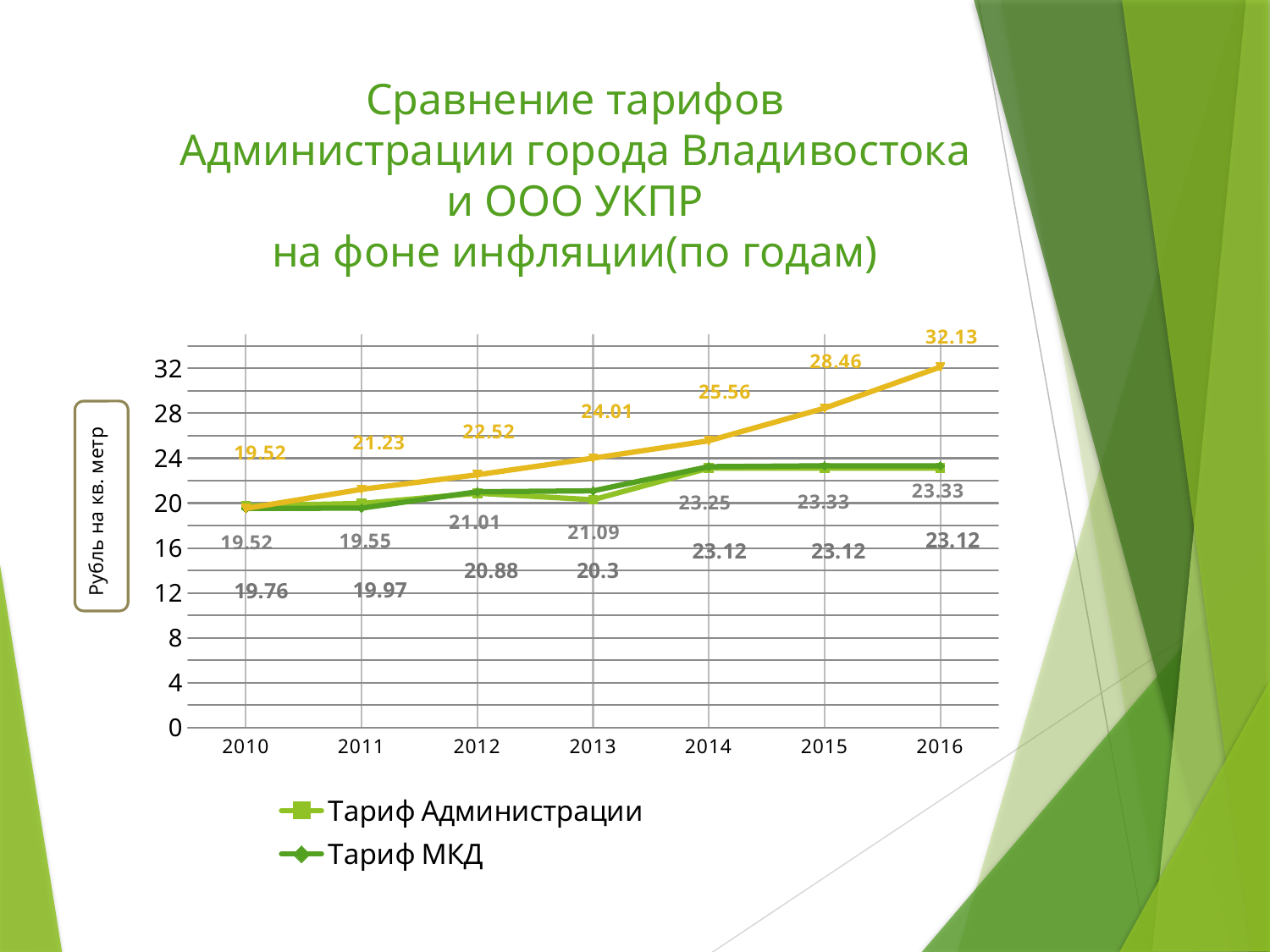
What are the first and last years shown on the x axis? 2010 and 2016 How many years are plotted along the x axis? 7 How many series does the legend list? 2 What is the highest data label shown on the chart? 32.13 By how much does the uppermost (yellow) line increase from 2010 (19.52) to 2016 (32.13)? 12.61 What is the value labelled on the uppermost (yellow) line for 2016? 32.13 What is the title of the vertical axis? Рубль на кв. метр Is the value of the uppermost (yellow) line in 2015 greater or less than 24? greater What is the value labelled on the uppermost (yellow) line for 2010? 19.52 Does the uppermost (yellow) line rise or fall from 2010 to 2016? rise What is the value labelled on the uppermost (yellow) line for 2013? 24.01 What kind of chart is shown on the slide? line chart